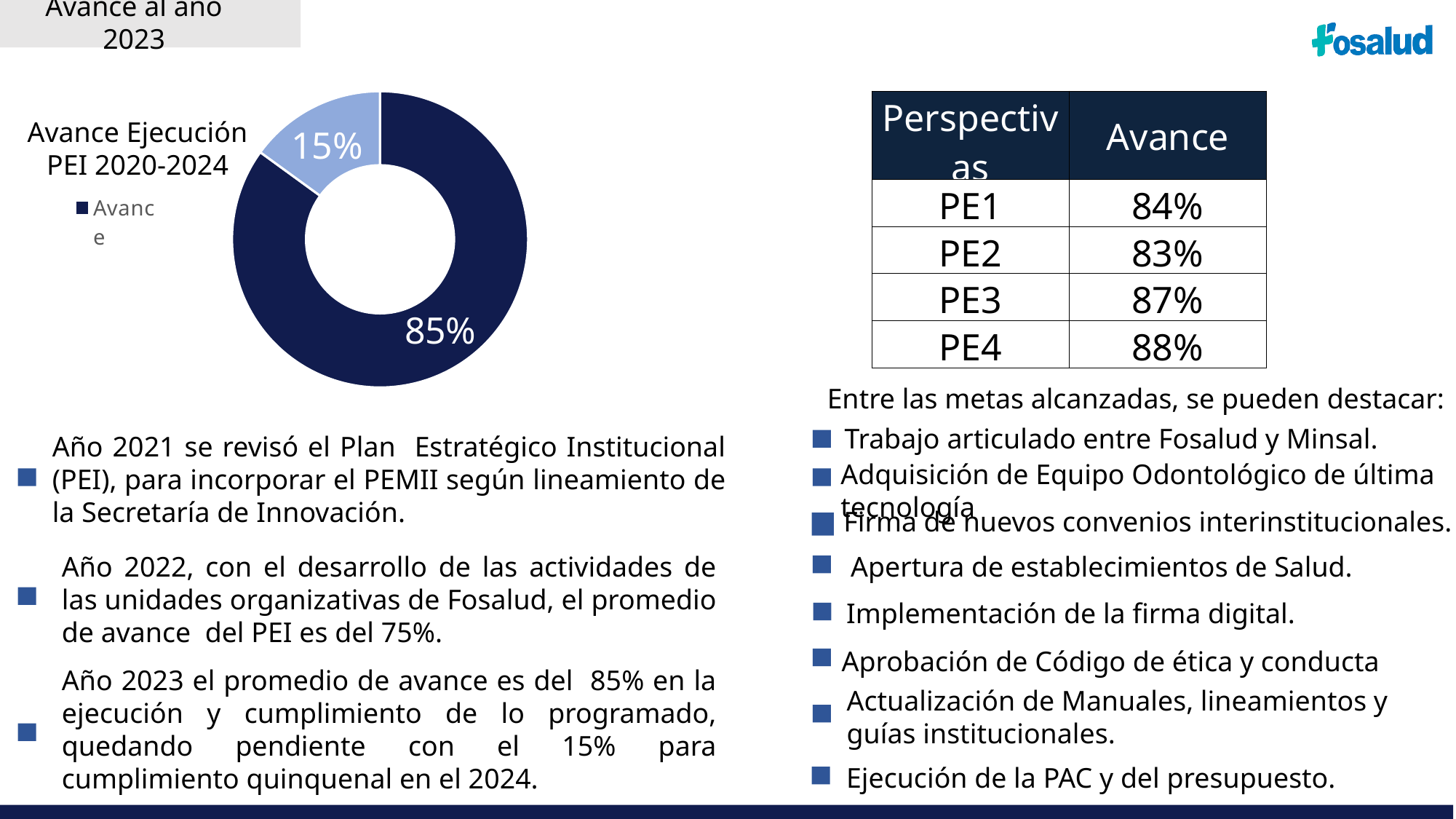
In the chart 'Avance Ejecución PEI 2020-2024', which slice is the largest? The dark blue slice (85%) How many slices does the chart 'Avance Ejecución PEI 2020-2024' have? 2 In the chart 'Avance Ejecución PEI 2020-2024', what percentage is shown on the light blue slice? 15% In the chart 'Avance Ejecución PEI 2020-2024', what percentage is shown on the dark blue slice? 85% In the chart 'Avance Ejecución PEI 2020-2024', what is the difference in percentage points between the two slices? 70 percentage points What is the title of the chart on the left of the slide? Avance Ejecución PEI 2020-2024 What kind of chart is shown on the left of the slide? Doughnut (pie) chart In the chart 'Avance Ejecución PEI 2020-2024', which slice is the smallest? The light blue slice (15%) In the chart 'Avance Ejecución PEI 2020-2024', is the value of the light blue slice greater or less than 50%? less In the chart 'Avance Ejecución PEI 2020-2024', is the dark blue slice larger or smaller than the light blue slice? Larger What legend entry is shown for the chart 'Avance Ejecución PEI 2020-2024'? Avance In the chart 'Avance Ejecución PEI 2020-2024', what share of the whole does the dark blue slice represent? 85%